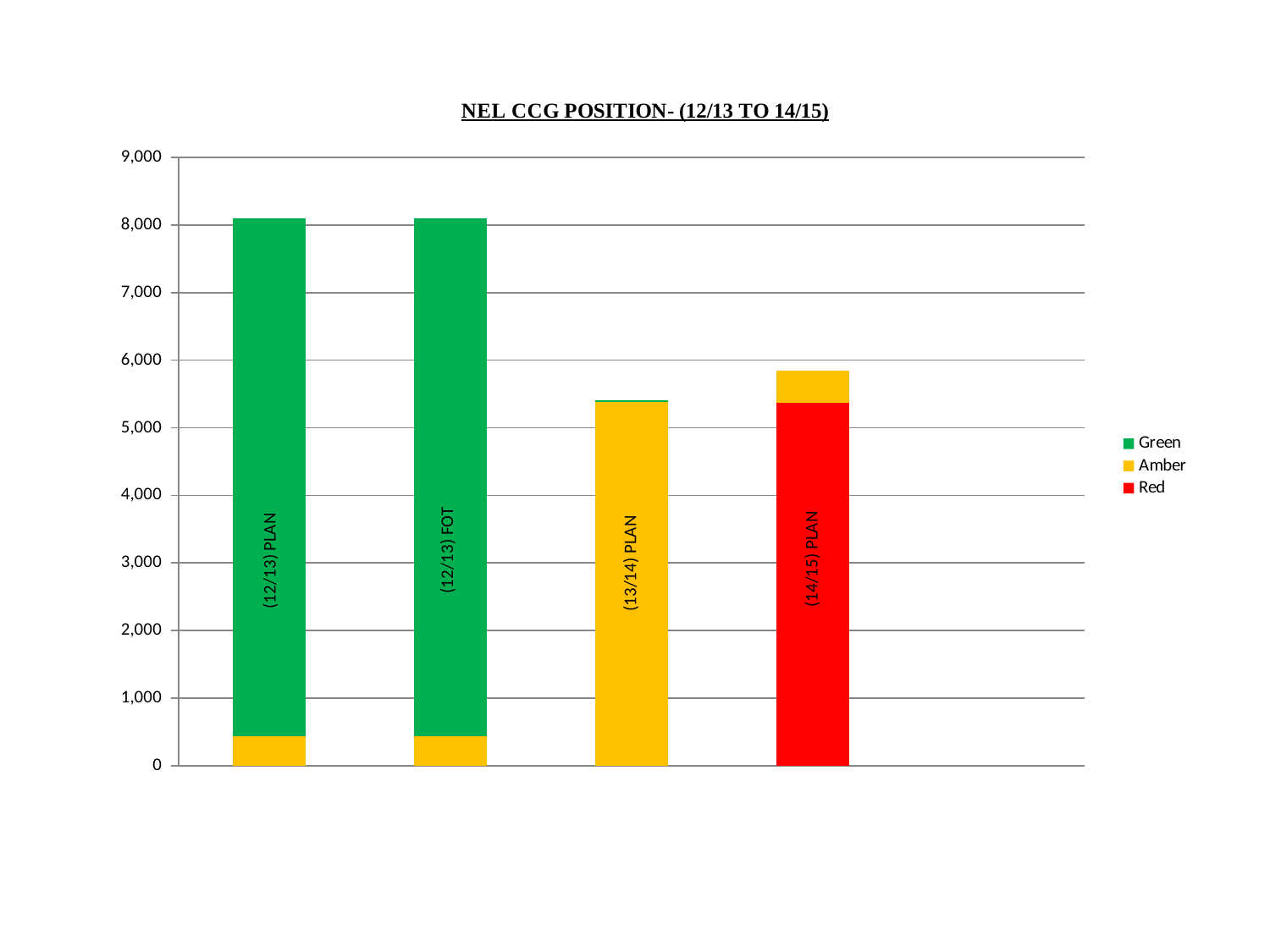
Is the total value for (13/14) PLAN greater or less than 6,000? less Is the total value for (12/13) PLAN greater or less than 8,000? greater Which bar has the lowest total value? (13/14) PLAN How many bars (categories) are plotted in the chart? 4 Is the total value for (14/15) PLAN greater or less than 5,000? greater What kind of chart is shown on the slide? Stacked bar chart What is the title of the chart? NEL CCG POSITION- (12/13 TO 14/15) How many series does the legend list? 3 Which has a larger total value, (13/14) PLAN or (14/15) PLAN? (14/15) PLAN Which series in the legend is shown in red? Red Which has a larger total value, (12/13) FOT or (13/14) PLAN? (12/13) FOT